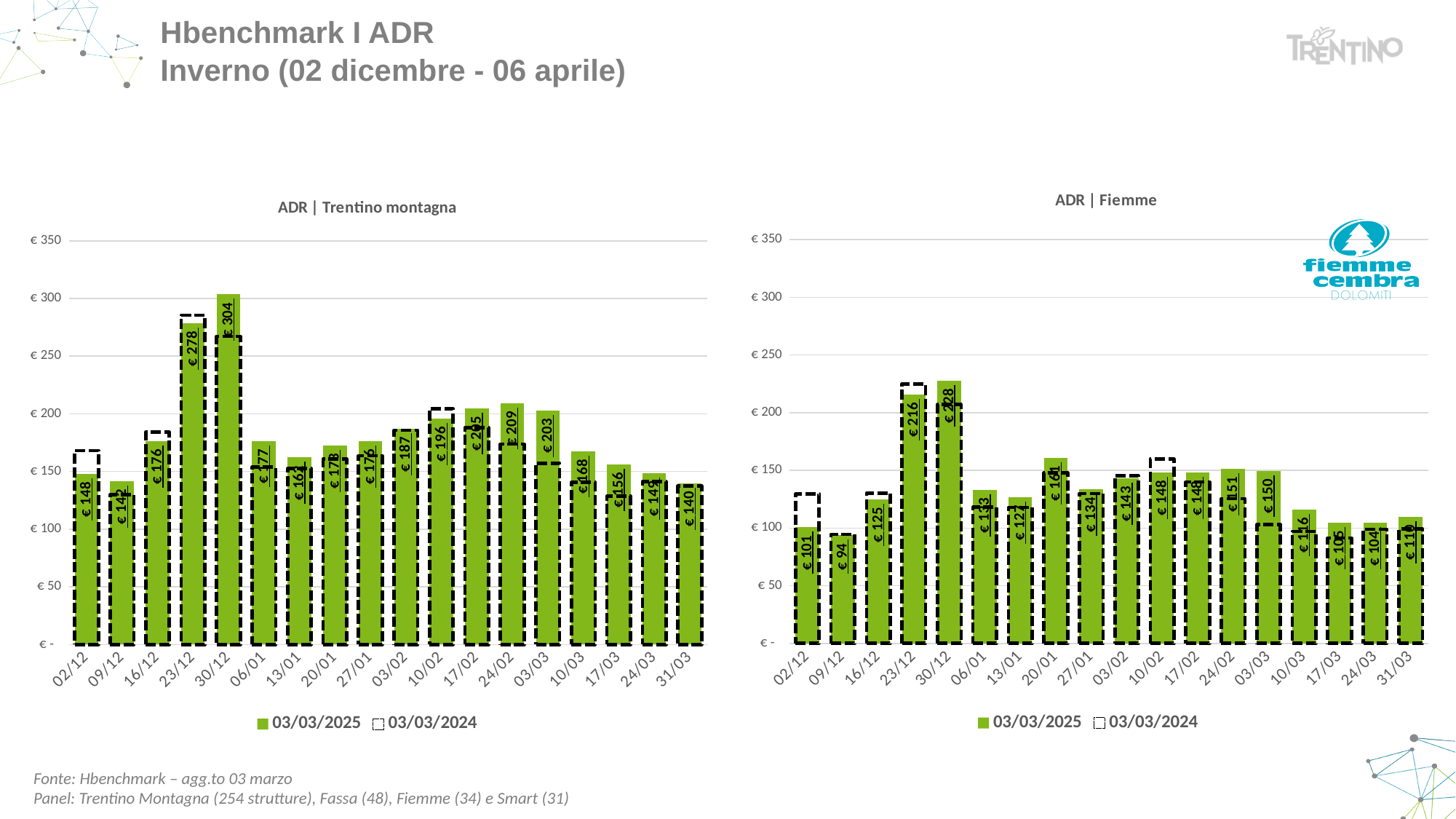
What kind of chart is 'ADR | Fiemme'? Bar chart How many series does the legend of the 'ADR | Trentino montagna' chart list? 2 In the 'ADR | Trentino montagna' chart, what is the 03/03/2025 value for 23/12? € 278 How many weeks are shown on the x axis of the 'ADR | Fiemme' chart? 18 In the 'ADR | Fiemme' chart, which week has the lowest 03/03/2025 value? 09/12 In the 'ADR | Fiemme' chart, what is the 03/03/2025 value for 23/12? € 216 In the 'ADR | Trentino montagna' chart, what is the difference between the 03/03/2025 values for 30/12 and 23/12? € 26 In the 'ADR | Fiemme' chart, which is larger for 03/03/2025: 30/12 or 23/12? 30/12 In the 'ADR | Fiemme' chart, what is the 03/03/2025 value for 02/12? € 101 In the 'ADR | Trentino montagna' chart, what is the 03/03/2025 value for 30/12? € 304 In the 'ADR | Trentino montagna' chart, which week has the highest 03/03/2025 value? 30/12 In the 'ADR | Trentino montagna' chart, is the 03/03/2024 value for 02/12 greater or less than € 150? greater